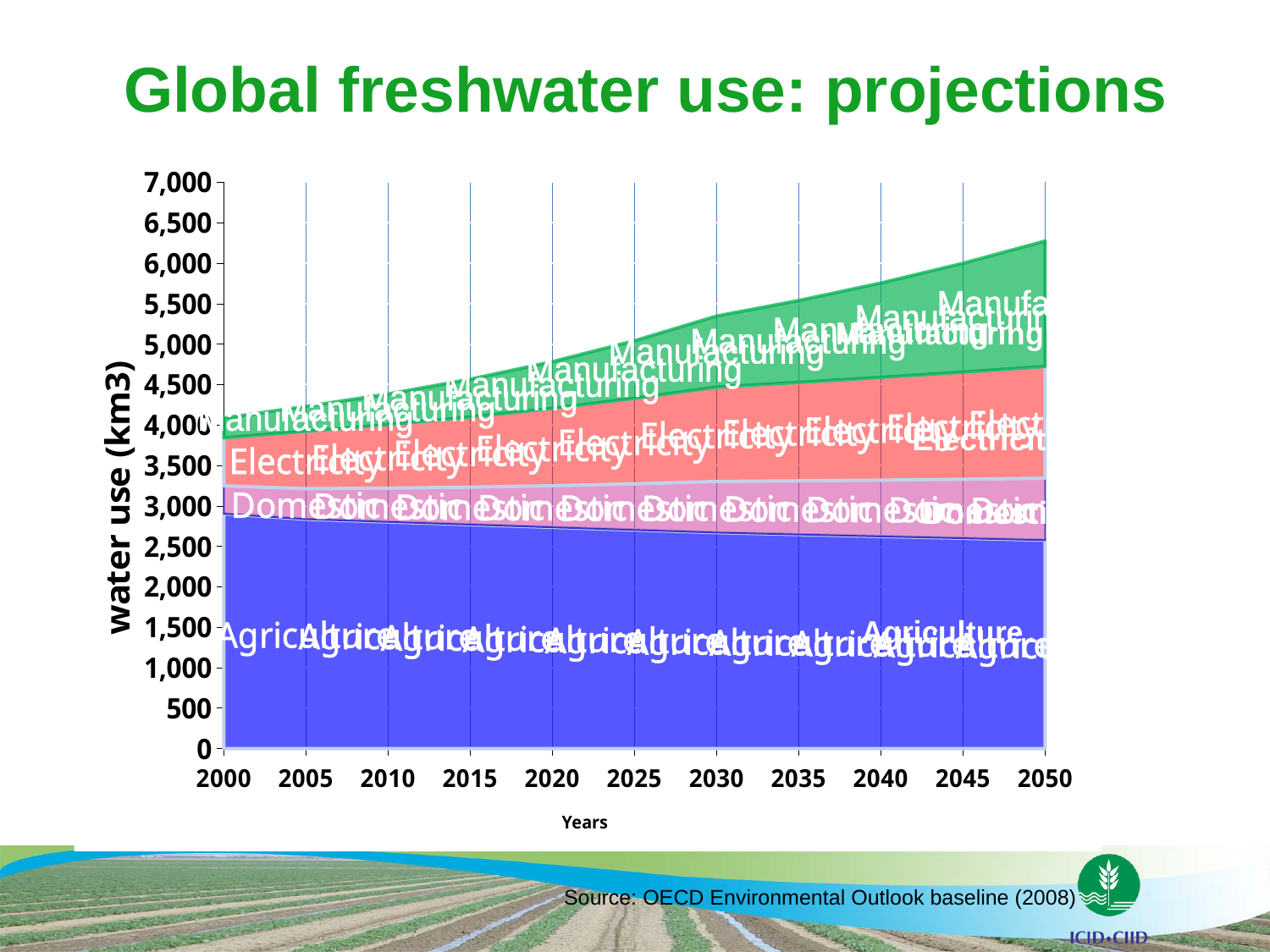
How many water-use sectors (series) are stacked in the chart? 4 Which sector is plotted at the bottom of the stack in the chart? Agriculture Does the Manufacturing band grow or shrink from 2000 to 2050? Grow What is the label on the y axis of the chart? water use (km3) Is the total freshwater use in 2030 greater or less than 5,000 km3? greater Is the Agriculture water use in 2050 greater or less than 3,000 km3? less How many years are marked along the x axis of the chart? 11 Which sector accounts for the smallest share of freshwater use in the chart? Domestic What kind of chart is shown on the slide? Stacked area chart Does total freshwater use rise or fall from 2000 to 2050 in the chart? Rise Is the total freshwater use in 2050 greater or less than 6,000 km3? greater Which sector accounts for the largest share of freshwater use in the chart? Agriculture